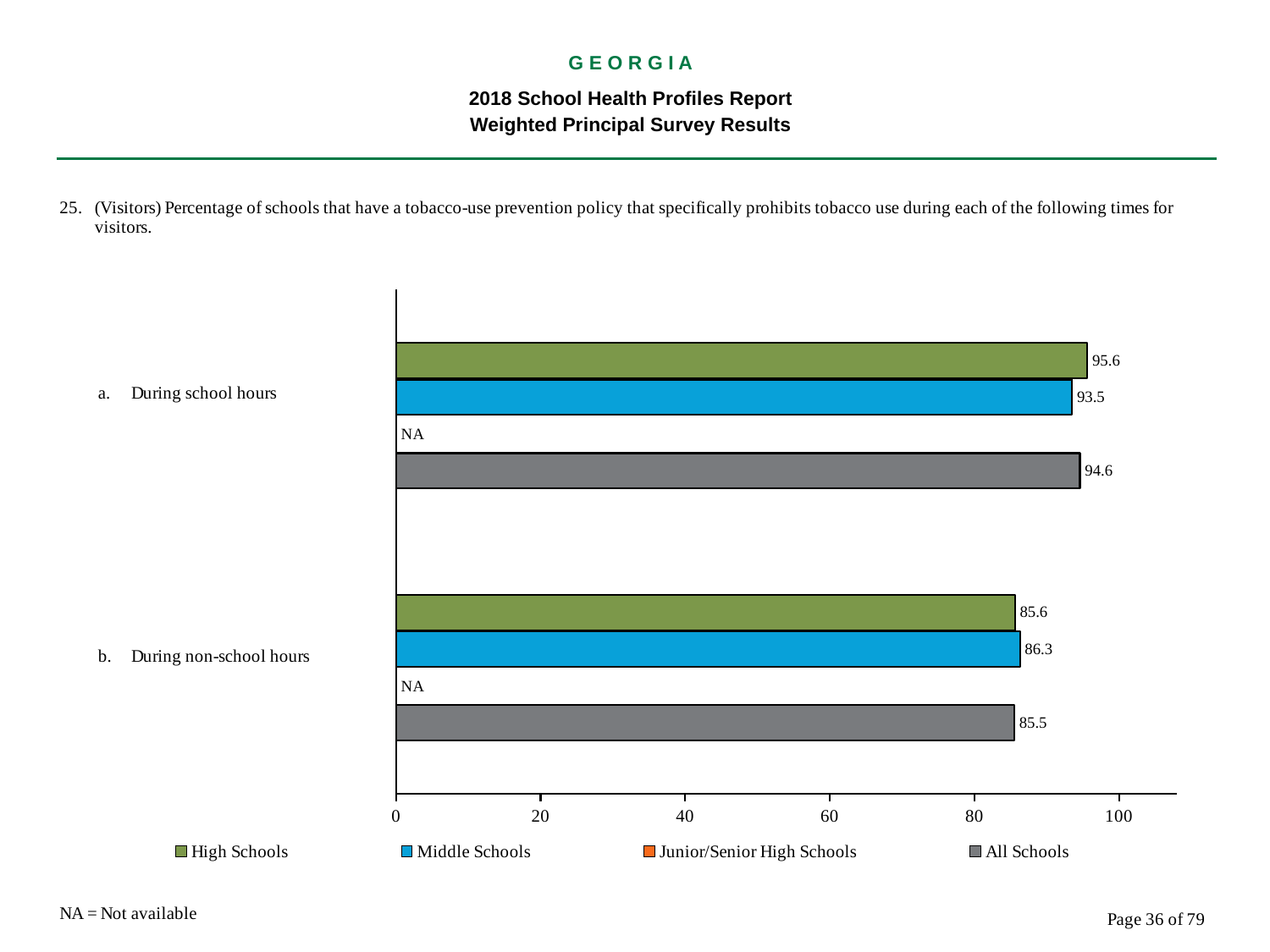
Which series has the lowest value during non-school hours? All Schools How many categories (time periods) are shown on the chart? 2 Is the value for All Schools during non-school hours greater or less than 80? greater How many series does the legend list? 4 What is the difference between the High Schools values during school hours and during non-school hours? 10.0 What is the value for All Schools during school hours? 94.6 What is shown for Junior/Senior High Schools during school hours? NA Which series has the highest value during school hours? High Schools Which is larger: the Middle Schools value during school hours or during non-school hours? During school hours What is the value for High Schools during school hours? 95.6 What is the value for Middle Schools during non-school hours? 86.3 What kind of chart is shown on the slide? Bar chart